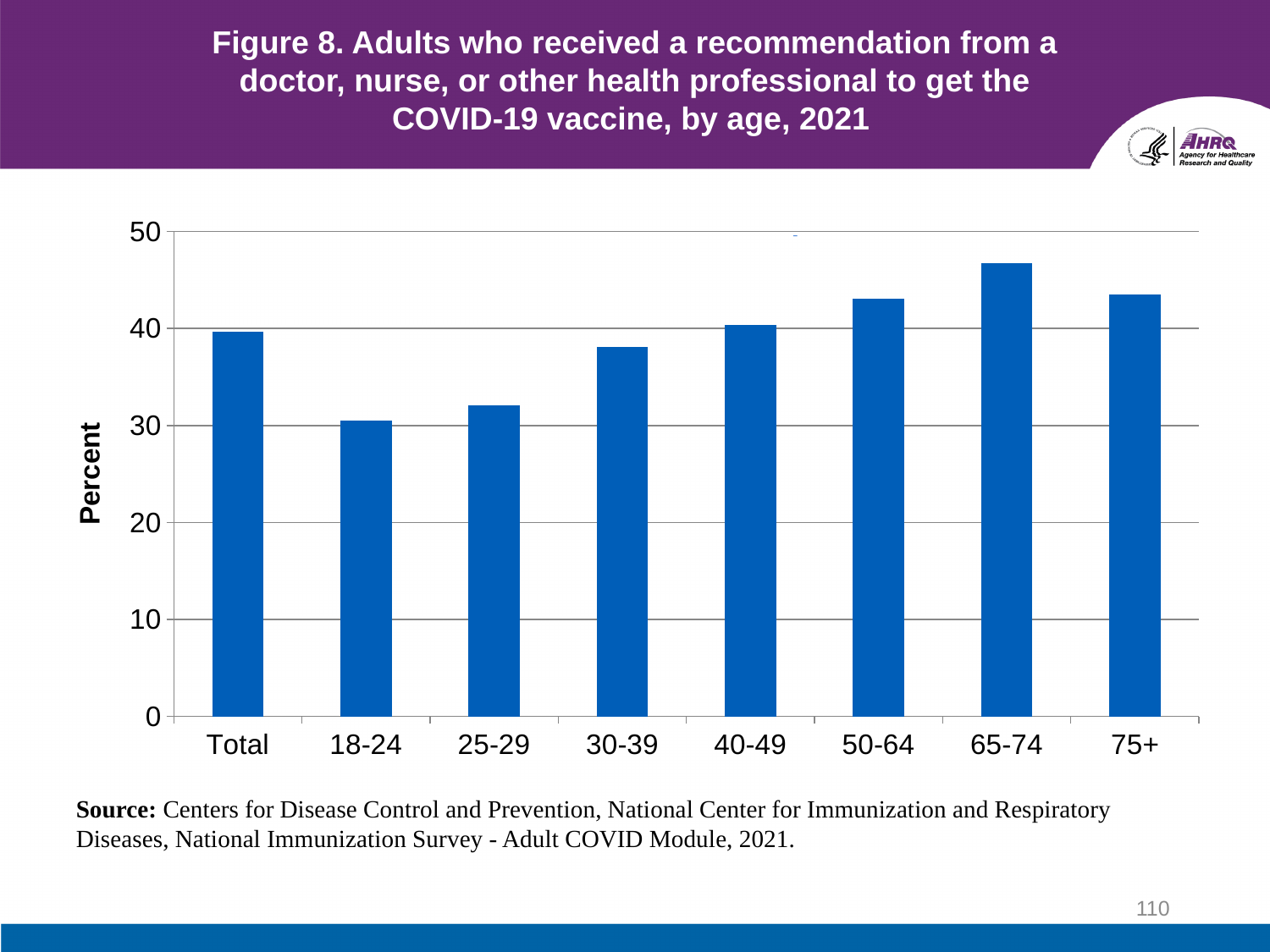
What kind of chart is shown on the slide? bar chart Is the value for the 50-64 age group greater or less than 40? greater Which age group has the highest percentage of adults who received a recommendation to get the COVID-19 vaccine? 65-74 How many categories are shown on the x axis of the chart? 8 Is the value for the 25-29 age group greater or less than 30? greater Do the values generally rise or fall across the age groups from 18-24 to 65-74? rise Which age group has the lowest percentage of adults who received a recommendation to get the COVID-19 vaccine? 18-24 Is the value for the 75+ age group greater or less than 40? greater Which is larger, the value for 30-39 or the value for 25-29? 30-39 Which is larger, the value for 65-74 or the value for 18-24? 65-74